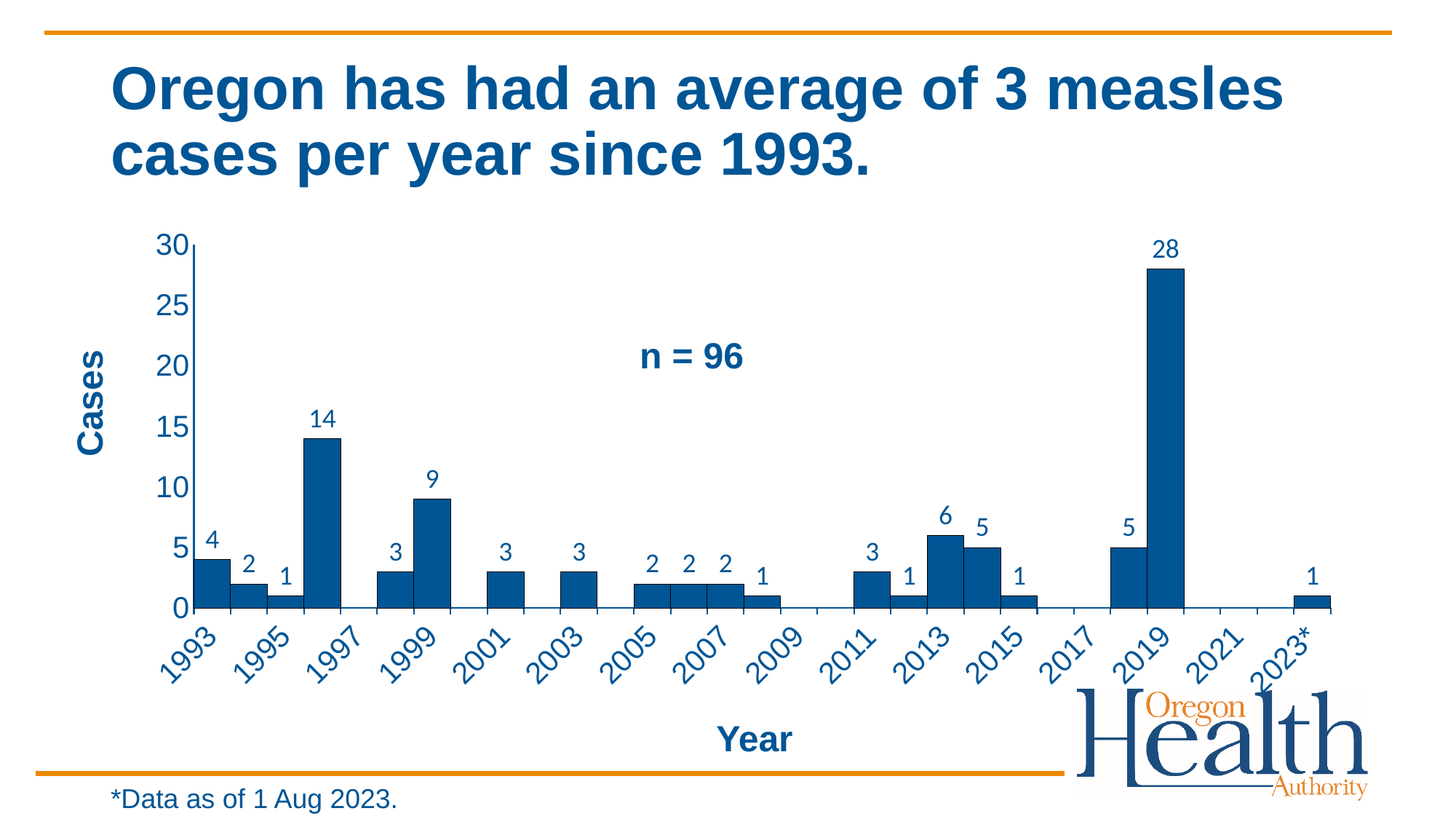
Which year had more cases, 2013 or 2011? 2013 What is the number of cases for 1999? 9 Which year has the highest number of cases? 2019 What total sample size (n) is printed on the chart? n = 96 What is the difference in cases between 2019 and 1999? 19 How many cases are shown for 2013? 6 What is the difference in cases between 2013 and 2015? 5 How many cases are shown for 1993? 4 What kind of chart is shown on the slide? bar chart How many cases are shown for 2023*? 1 Is the value for 2019 greater or less than 25? greater How many measles cases does the chart show for 2019? 28